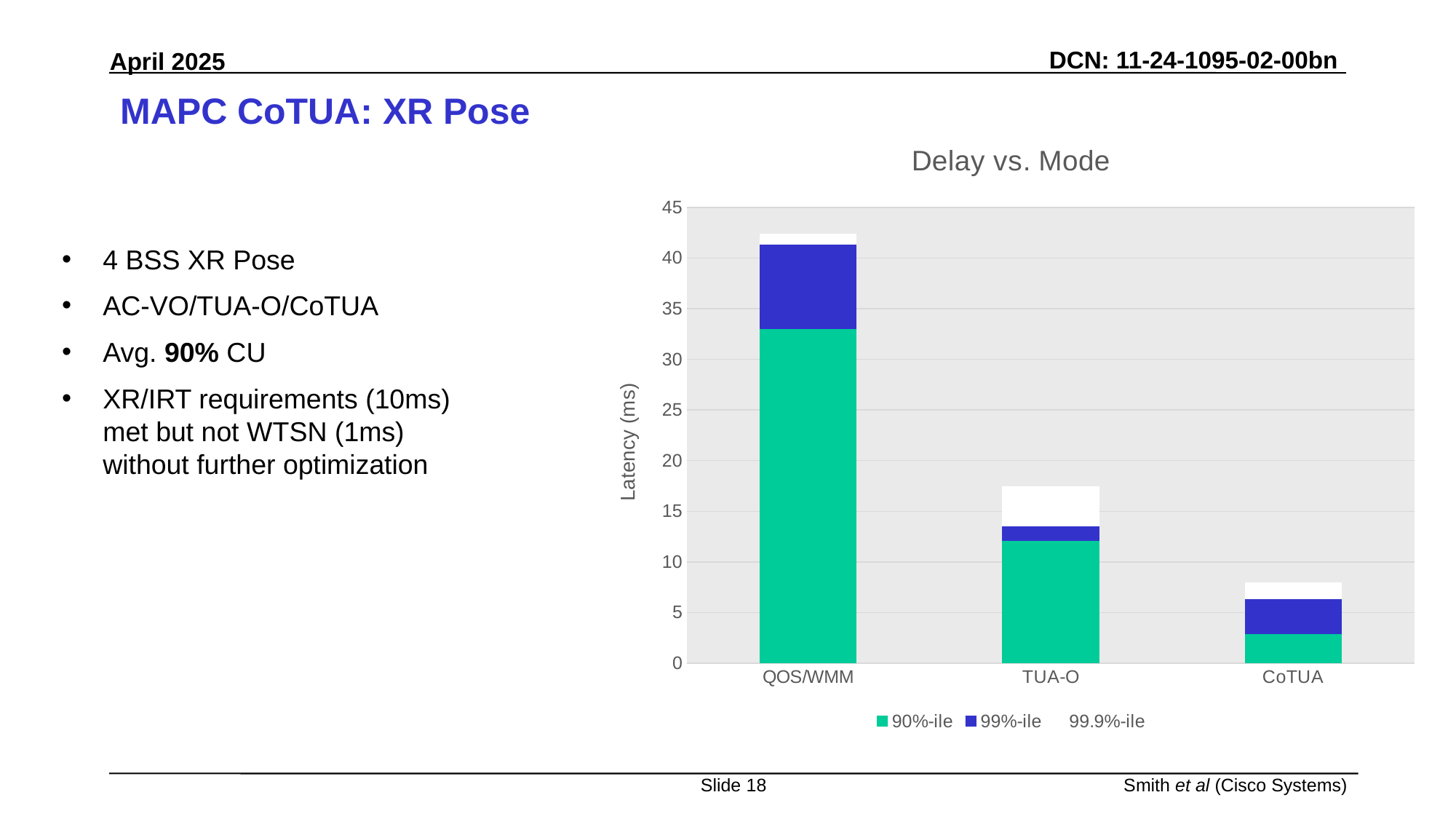
Is the 90%-ile latency for QOS/WMM greater or less than 30? greater What is the title of the chart? Delay vs. Mode Which mode has the lowest total latency bar? CoTUA What is the label of the vertical axis? Latency (ms) Is the 90%-ile latency for CoTUA greater or less than 5? less How many series does the legend list? 3 What kind of chart is shown on the slide? Stacked bar chart How many modes (categories) are shown on the x axis? 3 Is the 90%-ile latency for TUA-O greater or less than 10? greater Do the total latency bars rise or fall moving from QOS/WMM to CoTUA along the x axis? fall Which has the larger 90%-ile latency, TUA-O or CoTUA? TUA-O Which mode has the highest total latency bar? QOS/WMM